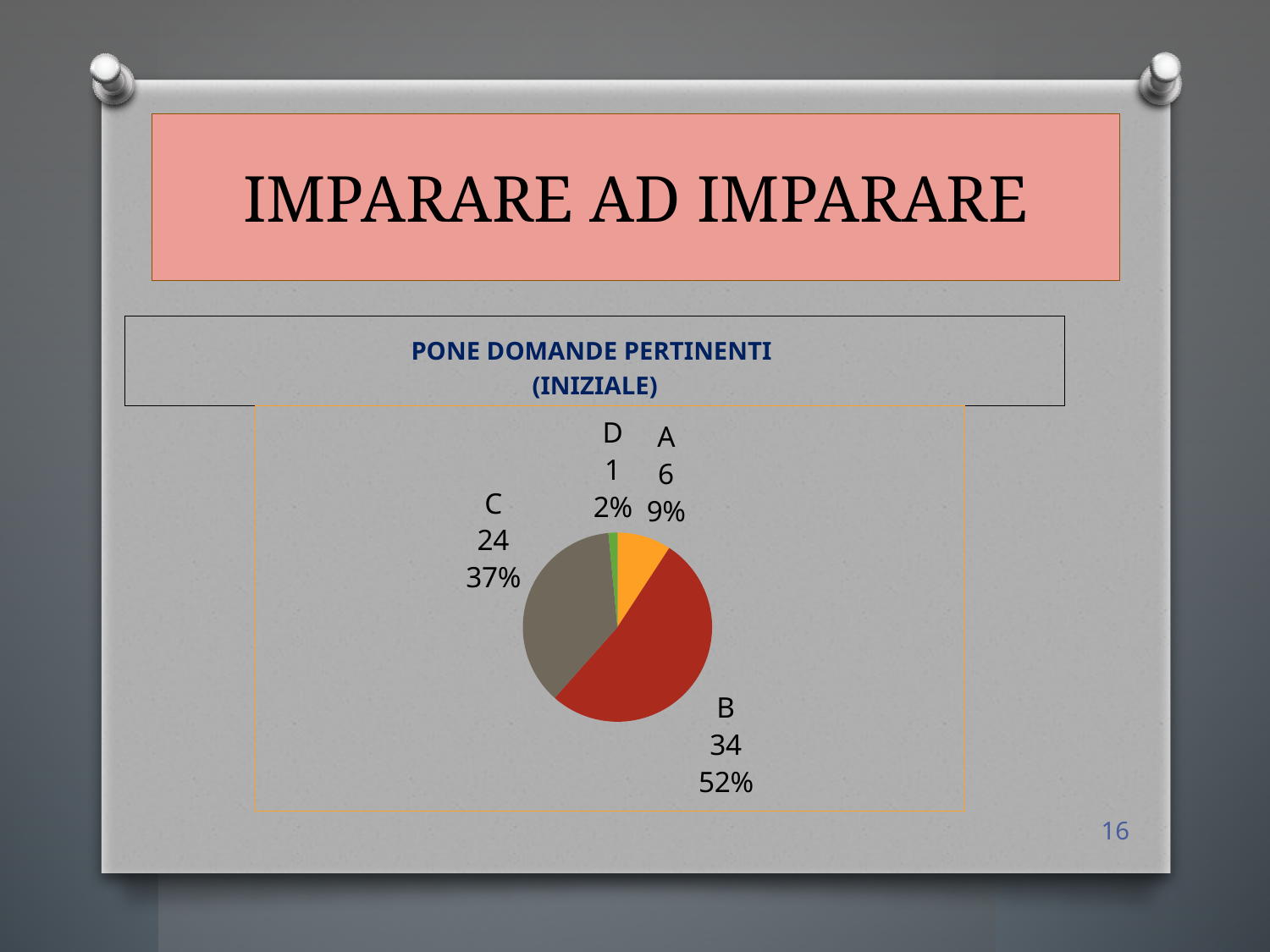
How many slices does the pie chart have? 4 What is the value for category B? 34 What is the value for category D? 1 What is the value for category C? 24 Which category has the largest slice? B What is the value for category A? 6 What kind of chart is shown on the slide? pie chart Which category has the smallest slice? D What is the title of the chart? PONE DOMANDE PERTINENTI (INIZIALE) What share of the pie does category C represent? 37% What is the difference between the values for B and C? 10 Which is larger, the value for A or the value for C? C